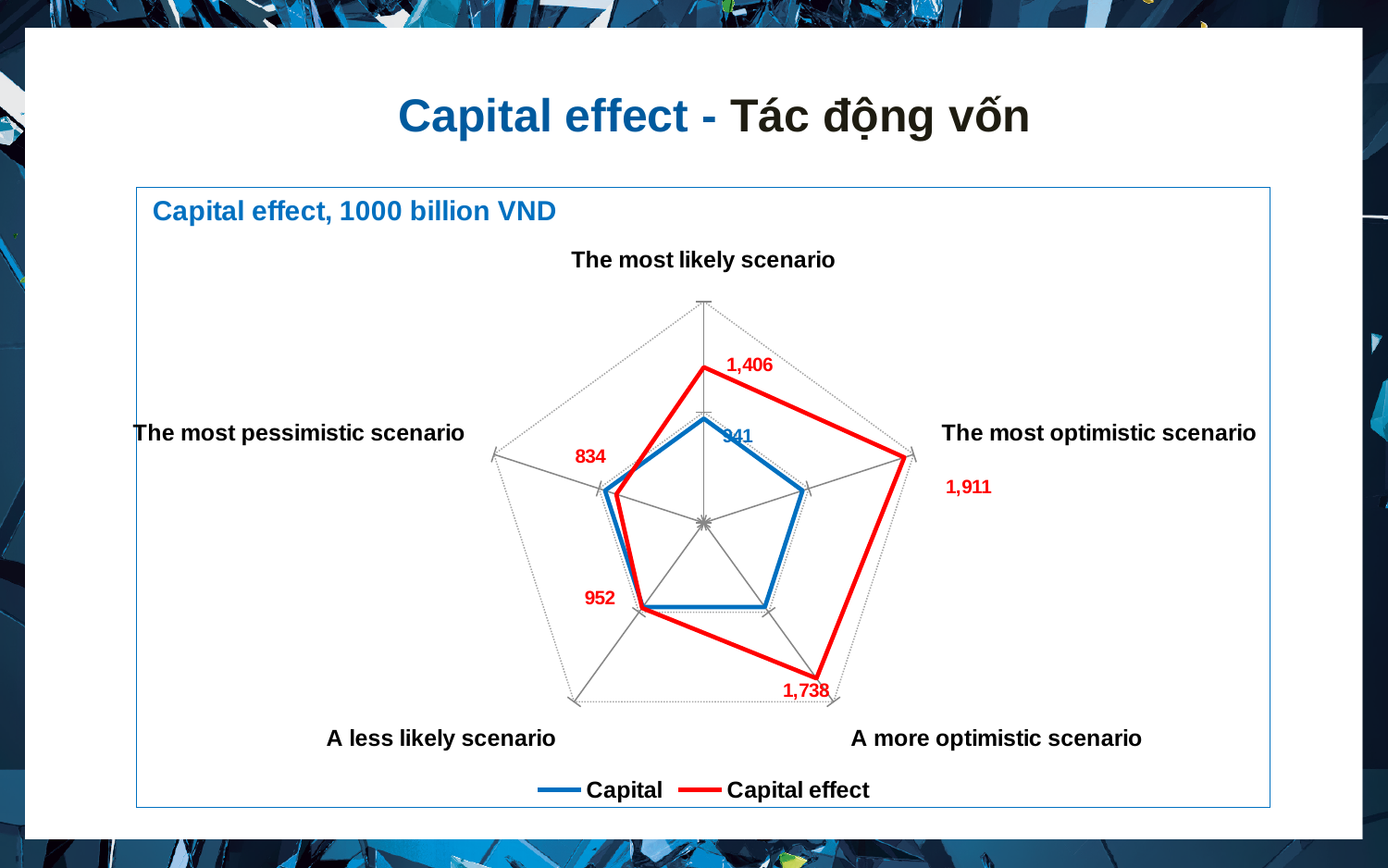
Which scenario has the highest Capital effect value? The most optimistic scenario What is the Capital effect value for the most optimistic scenario? 1,911 What is the Capital effect value for the most likely scenario? 1,406 Which scenario has the lowest Capital effect value? The most pessimistic scenario What kind of chart is shown on the slide? Radar chart How many series does the chart legend list? 2 What is the Capital effect value for the most pessimistic scenario? 834 How many scenarios (categories) are plotted on the radar chart? 5 What is the difference between the Capital effect values for the most optimistic scenario and a more optimistic scenario? 173 What is the title of the chart? Capital effect, 1000 billion VND What is the Capital effect value for a less likely scenario? 952 What is the Capital effect value for a more optimistic scenario? 1,738